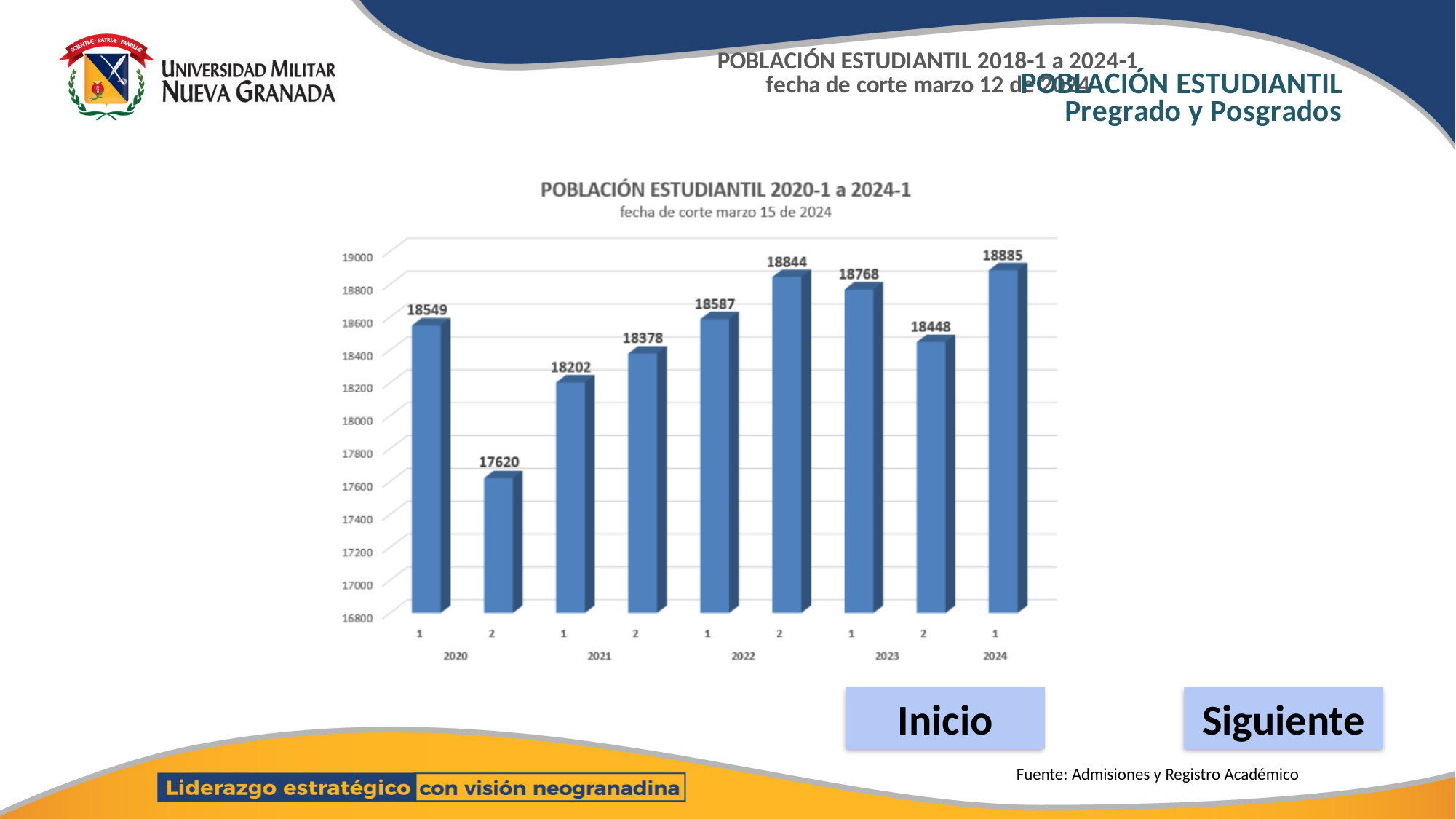
What is the student population value shown for period 1 of 2024? 18885 What is the cut-off date stated in the chart subtitle? marzo 15 de 2024 What is the student population value shown for period 2 of 2022? 18844 What is the difference between the student population in period 2 of 2022 and period 1 of 2023? 76 Which period has the highest student population in the chart? 2024 period 1 How many bars are plotted in the chart? 9 What is the difference between the student population in period 1 of 2024 and period 2 of 2020? 1265 Which is larger, the student population in period 1 of 2022 or period 2 of 2021? Period 1 of 2022 What type of chart is used to show the student population? Bar chart What is the student population value shown for period 1 of 2020? 18549 Which period has the lowest student population in the chart? 2020 period 2 Is the student population for period 2 of 2023 greater or less than 18600? less